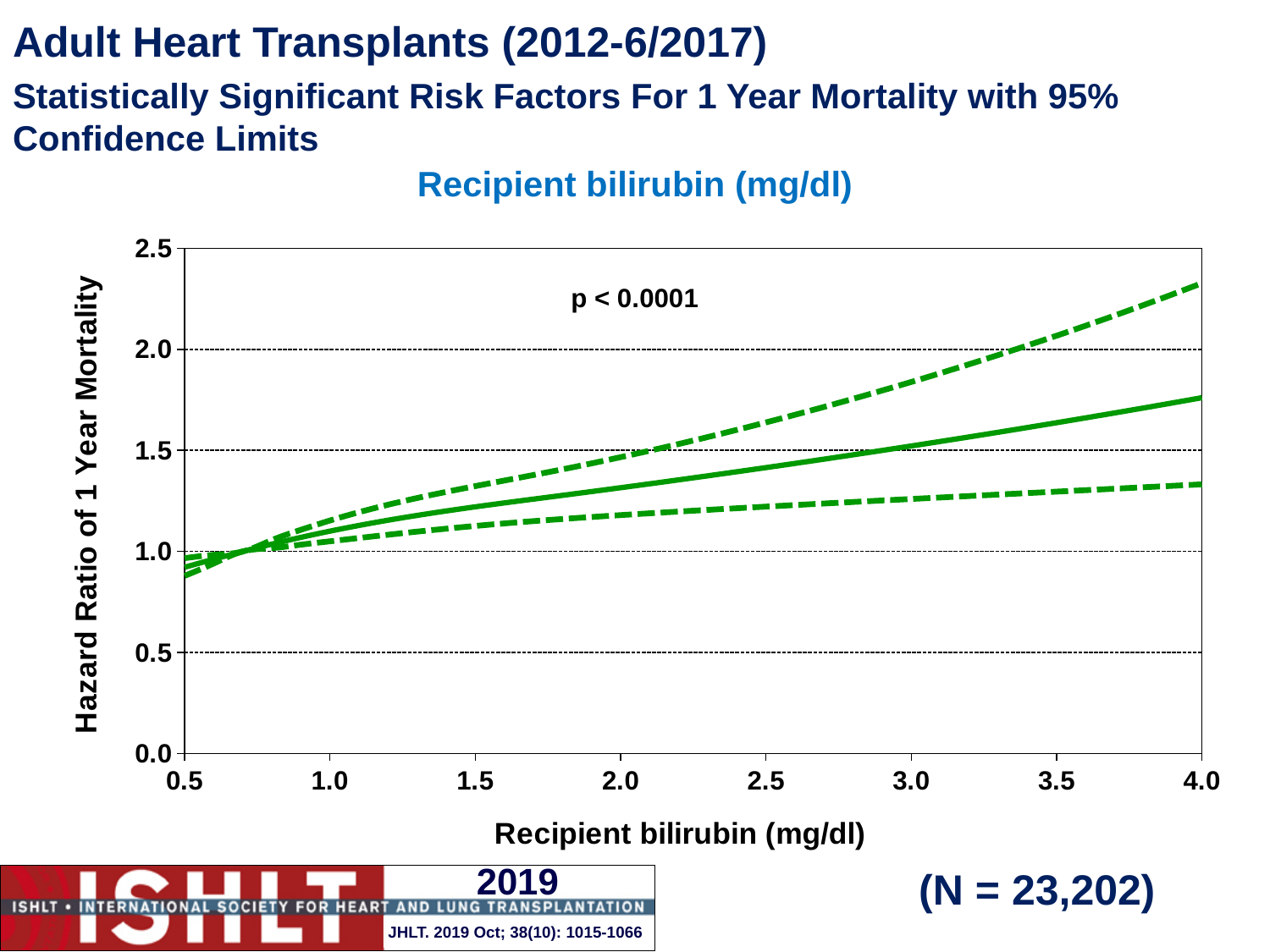
How many tick labels are shown on the x axis of the chart? 8 Is the hazard ratio on the solid line at a recipient bilirubin of 2.0 mg/dl greater or less than 1.5? less What sample size (N) is shown on the slide? N = 23,202 Is the hazard ratio on the solid line at a recipient bilirubin of 4.0 mg/dl greater or less than 1.5? greater Is the hazard ratio on the solid line at a recipient bilirubin of 1.0 mg/dl greater or less than 1.5? less What kind of chart is shown on the slide? line chart Does the hazard ratio of 1 year mortality (solid line) rise or fall as recipient bilirubin increases from 0.5 to 4.0 mg/dl? rise How many lines are plotted on the chart? 3 What p-value is printed on the chart? p < 0.0001